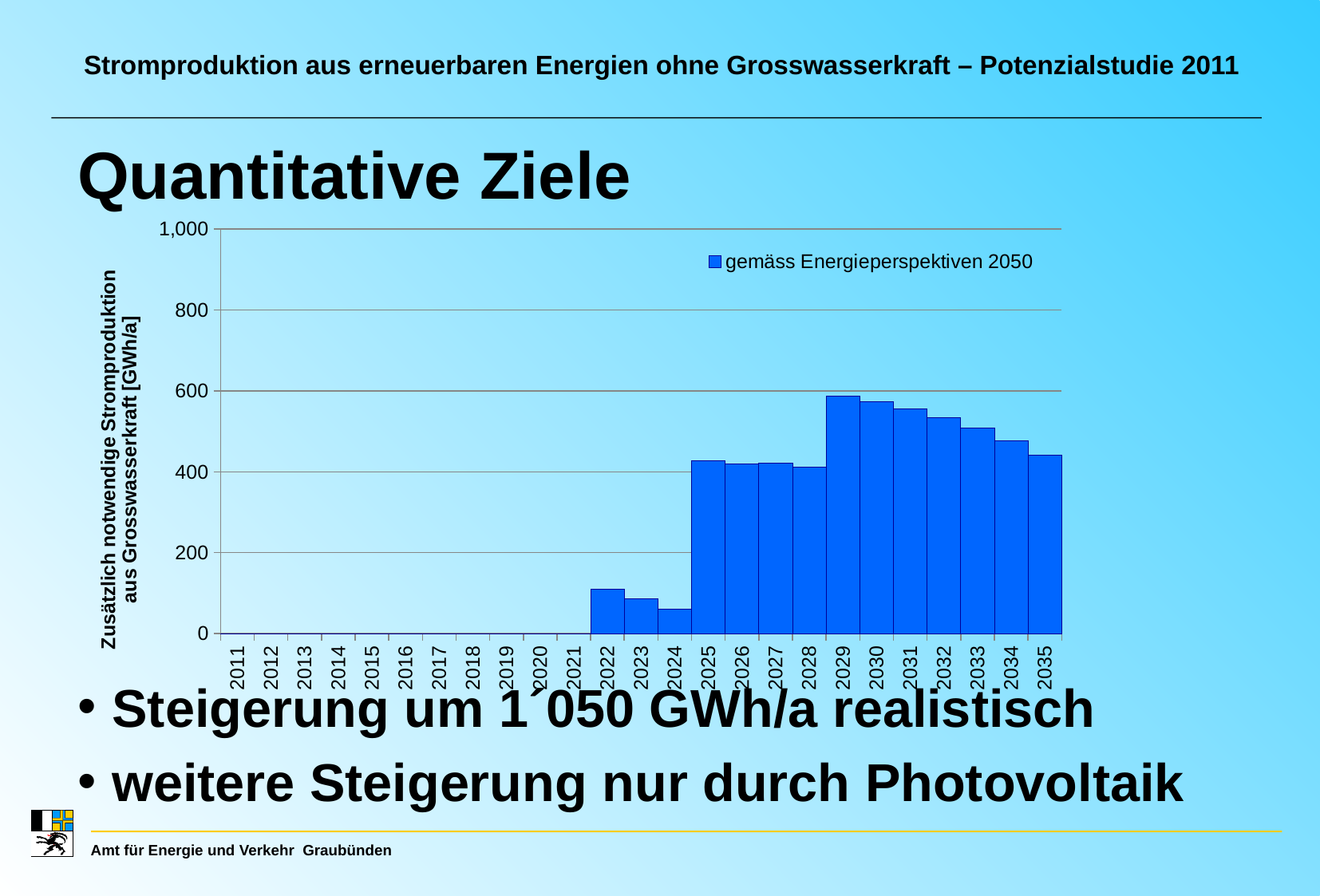
What kind of chart is shown on the slide? bar chart Is the value for 2024 greater or less than 200? less Is the value for 2035 greater or less than 400? greater What is the label of the y axis? Zusätzlich notwendige Stromproduktion aus Grosswasserkraft [GWh/a] Which year has the highest value in the chart? 2029 What is the legend entry for the series shown in the chart? gemäss Energieperspektiven 2050 How many years are shown on the x axis of the chart? 25 How many series does the legend list? 1 Do the values rise or fall from 2029 to 2035? fall Which is larger, the value for 2029 or the value for 2035? 2029 Is the value for 2022 greater or less than 200? less